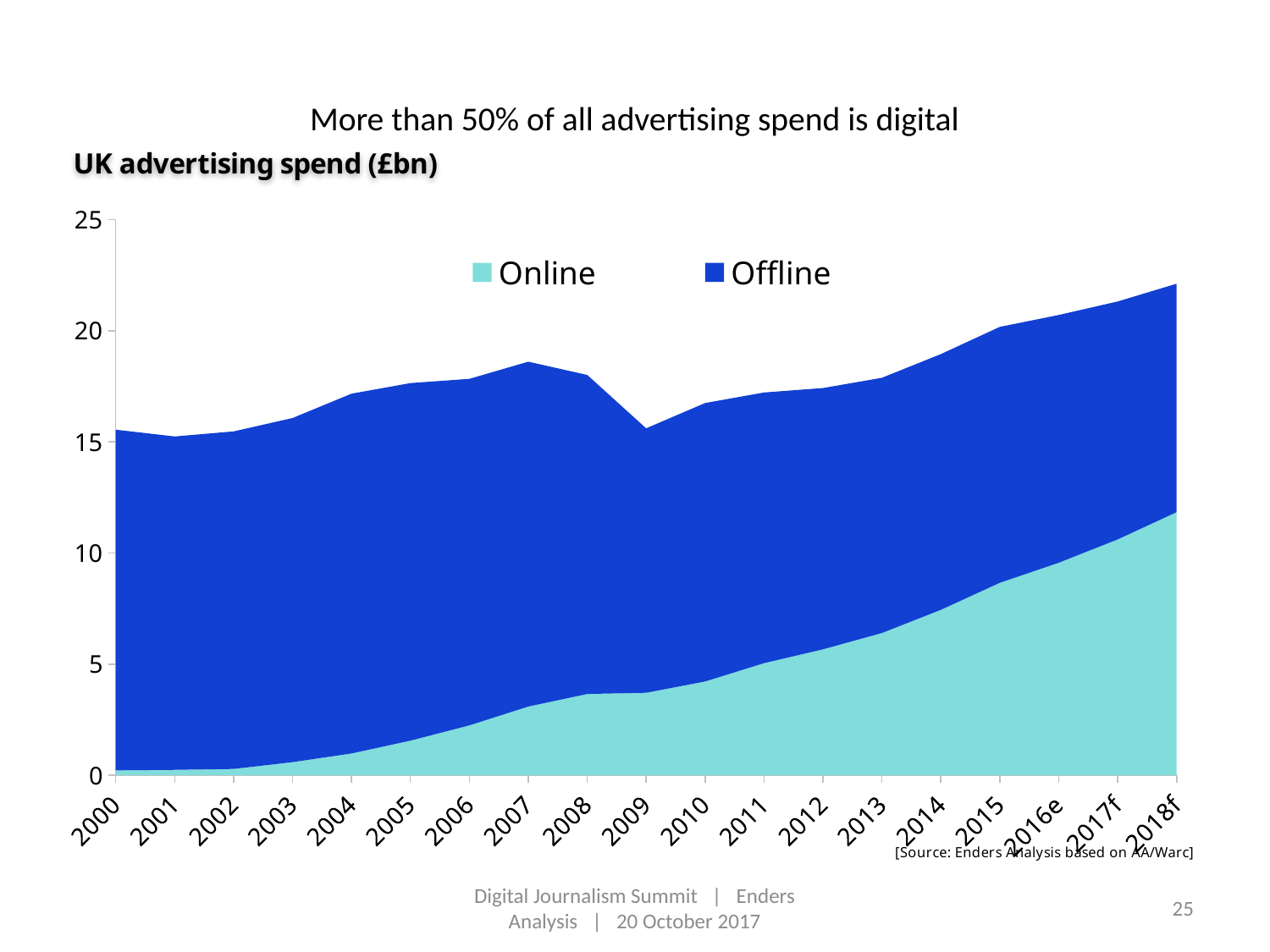
Which colour represents the Online series? Light teal Does the Online series rise or fall from 2000 to 2018f? Rises What is the title of the chart? UK advertising spend (£bn) Is the total advertising spend for 2018f greater or less than 20? greater How many years are shown along the x axis? 19 Is the total advertising spend for 2007 greater or less than 20? less In 2000, which is larger, Online or Offline spend? Offline What kind of chart is shown on the slide? Stacked area chart Is the Online value for 2000 greater or less than 5? less Which year has the highest total advertising spend? 2018f How many series does the legend list? 2